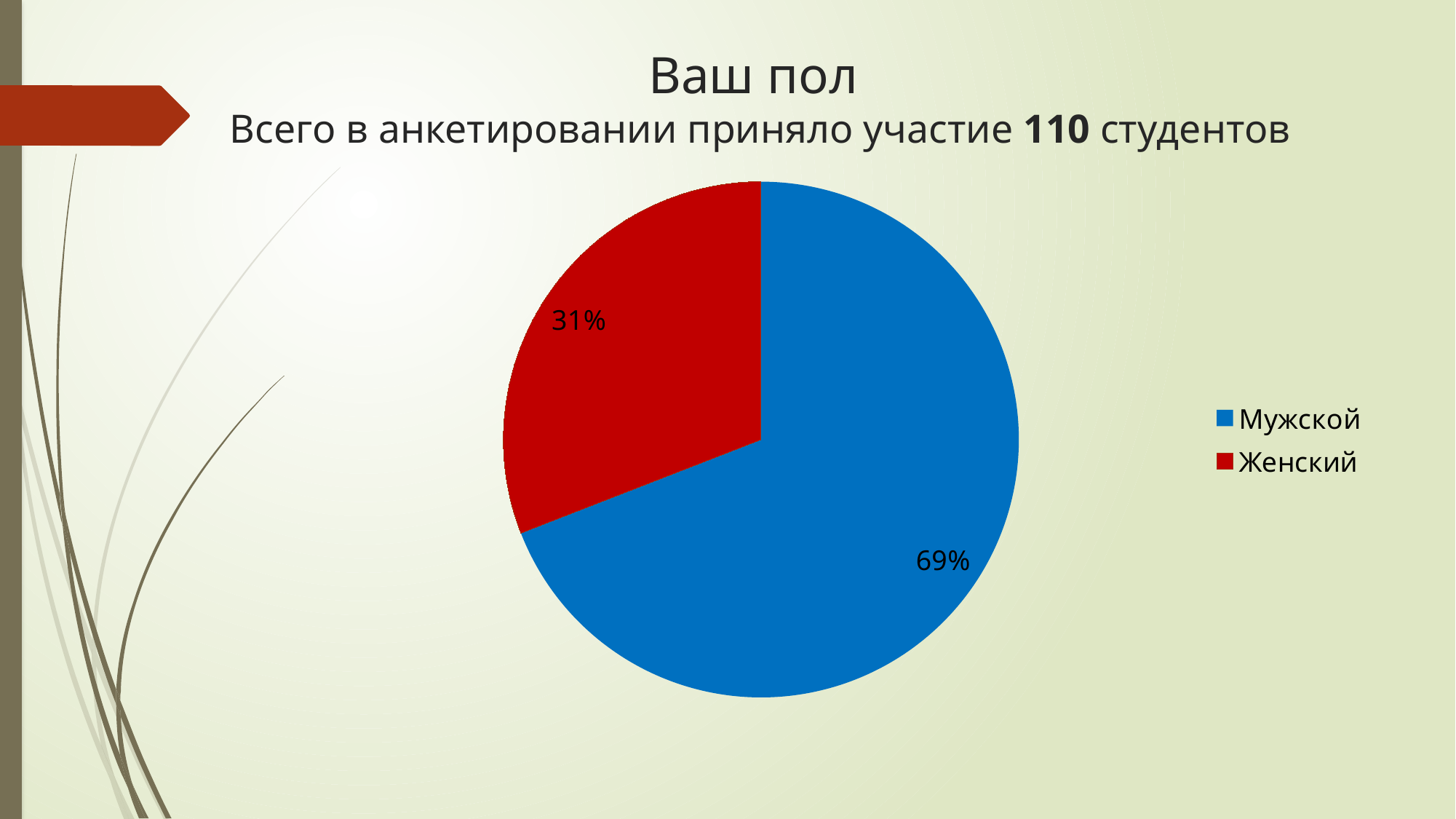
How many slices does the pie chart have? 2 Which category has the largest slice of the pie? Мужской What is the difference in percentage points between the Мужской and Женский slices? 38 What is the title of the chart on the slide? Ваш пол What share of the pie does Мужской have? 69% Which slice is larger, Мужской or Женский? Мужской What colour is the Женский slice? red How many entries does the legend list? 2 Which category has the smallest slice of the pie? Женский What share of the pie does Женский have? 31% Is the share for Женский greater or less than 50%? less What kind of chart is shown on the slide? pie chart